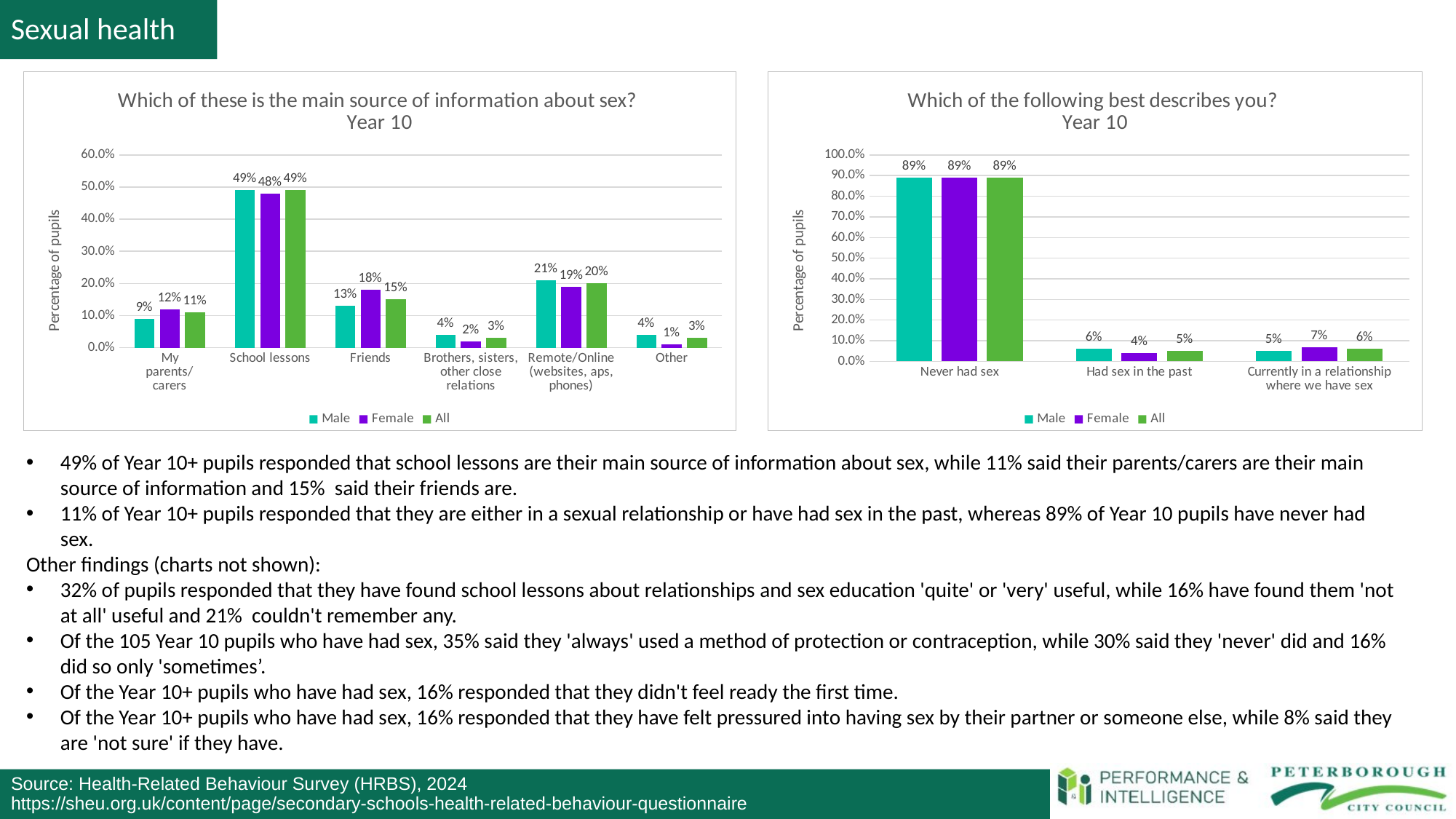
In the chart 'Which of the following best describes you? Year 10', how many series does the legend list? 3 In the chart 'Which of the following best describes you? Year 10', what is the difference between the All values for Never had sex and Had sex in the past? 84% In the chart 'Which of these is the main source of information about sex? Year 10', which category has the highest value for All? School lessons In the chart 'Which of the following best describes you? Year 10', which is larger for Had sex in the past: Male or Female? Male What kind of chart is 'Which of the following best describes you? Year 10'? Bar chart In the chart 'Which of these is the main source of information about sex? Year 10', what is the value for Female for School lessons? 48% In the chart 'Which of these is the main source of information about sex? Year 10', what is the difference between the Female and Male values for Friends? 5% In the chart 'Which of these is the main source of information about sex? Year 10', which category has the lowest value for Female? Other In the chart 'Which of these is the main source of information about sex? Year 10', is the Male value for School lessons greater or less than 40.0%? greater In the chart 'Which of these is the main source of information about sex? Year 10', how many categories are shown on the x axis? 6 In the chart 'Which of these is the main source of information about sex? Year 10', what is the value for Male for Remote/Online (websites, aps, phones)? 21% In the chart 'Which of the following best describes you? Year 10', what is the value for Female for Currently in a relationship where we have sex? 7%